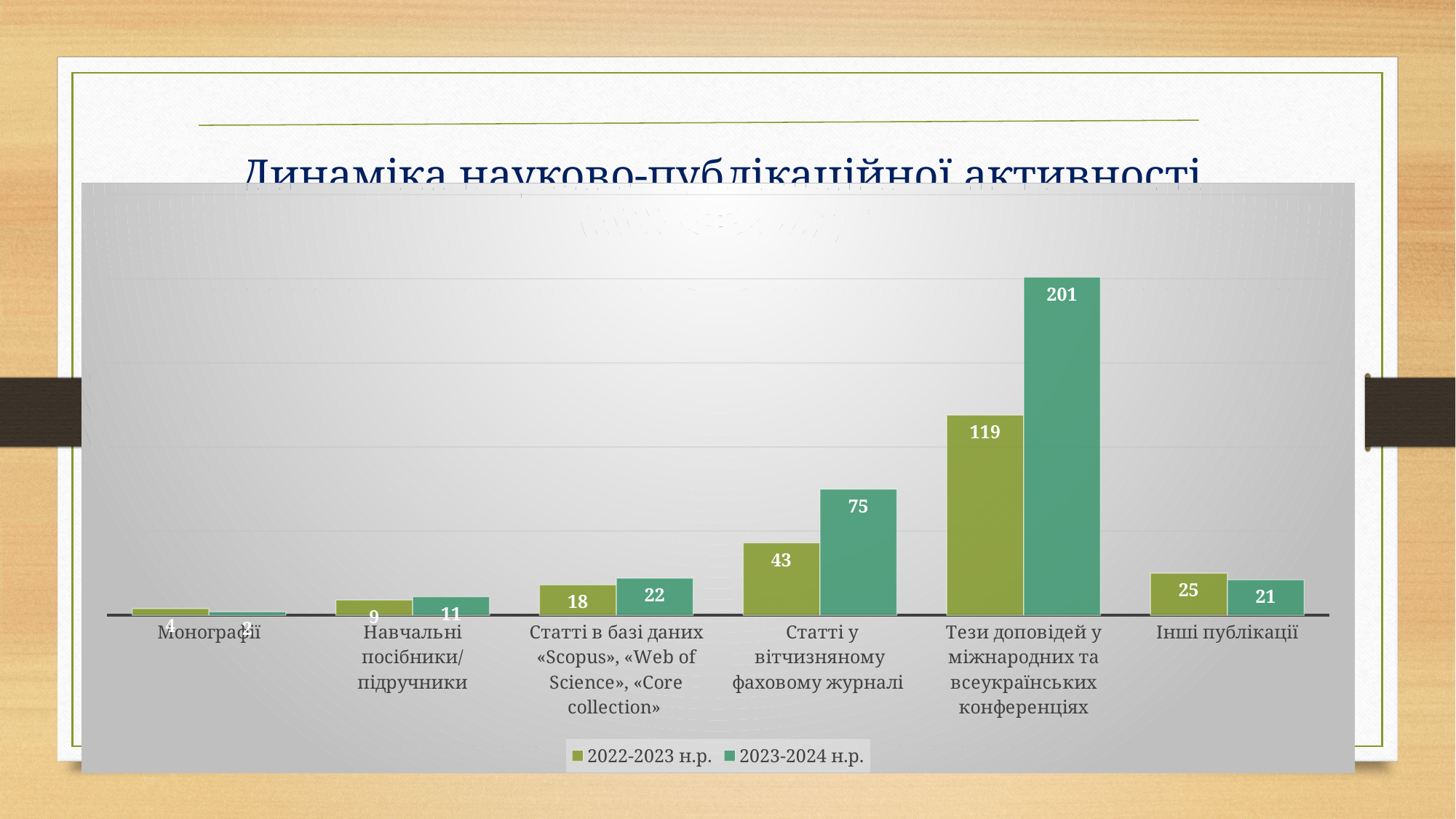
What is the value for 2022-2023 н.р. in the category «Інші публікації»? 25 What is the value for 2023-2024 н.р. in the category «Статті в базі даних «Scopus», «Web of Science», «Core collection»»? 22 For «Інші публікації», which series has the larger value, 2022-2023 н.р. or 2023-2024 н.р.? 2022-2023 н.р. What is the value for 2023-2024 н.р. in the category «Тези доповідей у міжнародних та всеукраїнських конференціях»? 201 What is the value for 2022-2023 н.р. in the category «Статті у вітчизняному фаховому журналі»? 43 How many series does the legend list? 2 What is the difference between the 2023-2024 н.р. and 2022-2023 н.р. values for «Тези доповідей у міжнародних та всеукраїнських конференціях»? 82 Which series is shown in the darker teal-green colour in the legend? 2023-2024 н.р. Which category has the highest value for the 2023-2024 н.р. series? Тези доповідей у міжнародних та всеукраїнських конференціях What kind of chart is shown on the slide? Bar chart What is the difference between the 2023-2024 н.р. and 2022-2023 н.р. values for «Статті у вітчизняному фаховому журналі»? 32 How many categories are shown on the x axis? 6